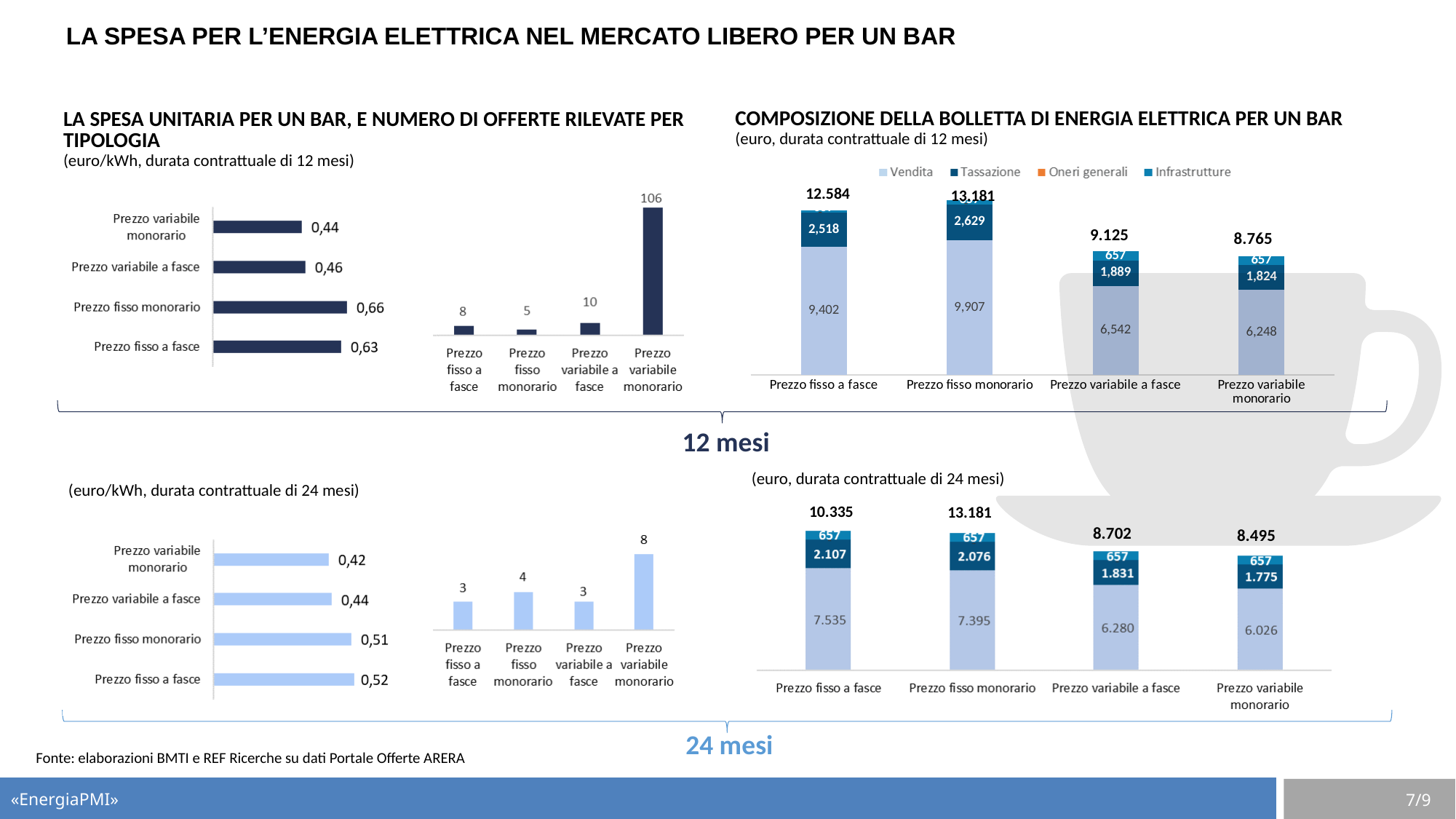
In the top-right stacked bar chart (Composizione della bolletta, 12 mesi), what is the total for Prezzo fisso monorario? 13.181 What type of chart is the top-left chart showing euro/kWh for 12 mesi? Bar chart In the bottom-right stacked bar chart (24 mesi), what is the Tassazione value for Prezzo variabile monorario? 1.775 How many series does the legend of the top-right stacked bar chart (Composizione della bolletta, 12 mesi) list? 4 In the bottom-middle bar chart showing the number of offers for 24 mesi, which category has the highest value? Prezzo variabile monorario In the top-left horizontal bar chart (euro/kWh, 12 mesi), what is the value for Prezzo fisso monorario? 0,66 In the top-middle bar chart showing the number of offers for 12 mesi, what is the difference between Prezzo variabile a fasce and Prezzo fisso monorario? 5 In the top-right stacked bar chart (Composizione della bolletta, 12 mesi), what is the Vendita value for Prezzo variabile a fasce? 6,542 In the top-left horizontal bar chart (euro/kWh, 12 mesi), which category has the lowest value? Prezzo variabile monorario In the bottom-left horizontal bar chart (euro/kWh, 24 mesi), which is larger: Prezzo variabile a fasce or Prezzo fisso monorario? Prezzo fisso monorario In the top-middle bar chart showing the number of offers for 12 mesi, what is the value for Prezzo variabile monorario? 106 In the bottom-left horizontal bar chart (euro/kWh, 24 mesi), what is the value for Prezzo fisso a fasce? 0,52